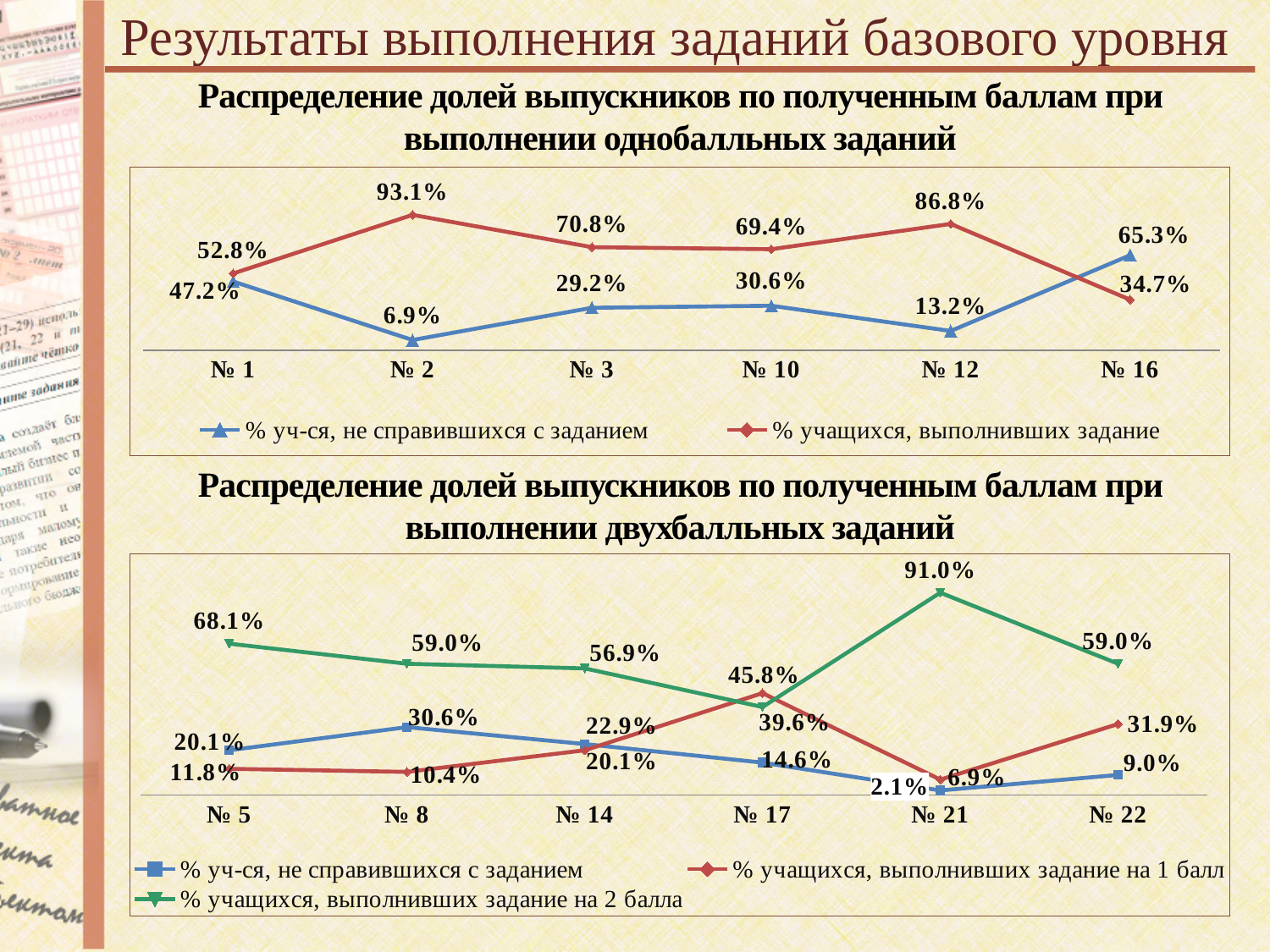
In the top chart (однобалльных заданий), what is the value of '% учащихся, выполнивших задание' for № 2? 93.1% In the bottom chart (двухбалльных заданий), what is the value of '% учащихся, выполнивших задание на 1 балл' for № 17? 45.8% In the top chart (однобалльных заданий), for which task is '% уч-ся, не справившихся с заданием' the lowest? № 2 In the top chart (однобалльных заданий), what is the value of '% уч-ся, не справившихся с заданием' for № 16? 65.3% In the bottom chart (двухбалльных заданий), which is larger for № 8: '% уч-ся, не справившихся с заданием' or '% учащихся, выполнивших задание на 1 балл'? % уч-ся, не справившихся с заданием In the bottom chart (двухбалльных заданий), what is the value of '% учащихся, выполнивших задание на 2 балла' for № 21? 91.0% In the bottom chart (двухбалльных заданий), for which task is '% уч-ся, не справившихся с заданием' the lowest? № 21 How many series does the legend of the bottom chart (двухбалльных заданий) list? 3 What type of chart is the top chart (однобалльных заданий)? Line chart In the top chart (однобалльных заданий), what is the difference between '% учащихся, выполнивших задание' and '% уч-ся, не справившихся с заданием' for № 12? 73.6% In the top chart (однобалльных заданий), how many tasks are shown on the x axis? 6 In the top chart (однобалльных заданий), for which task is '% учащихся, выполнивших задание' the highest? № 2